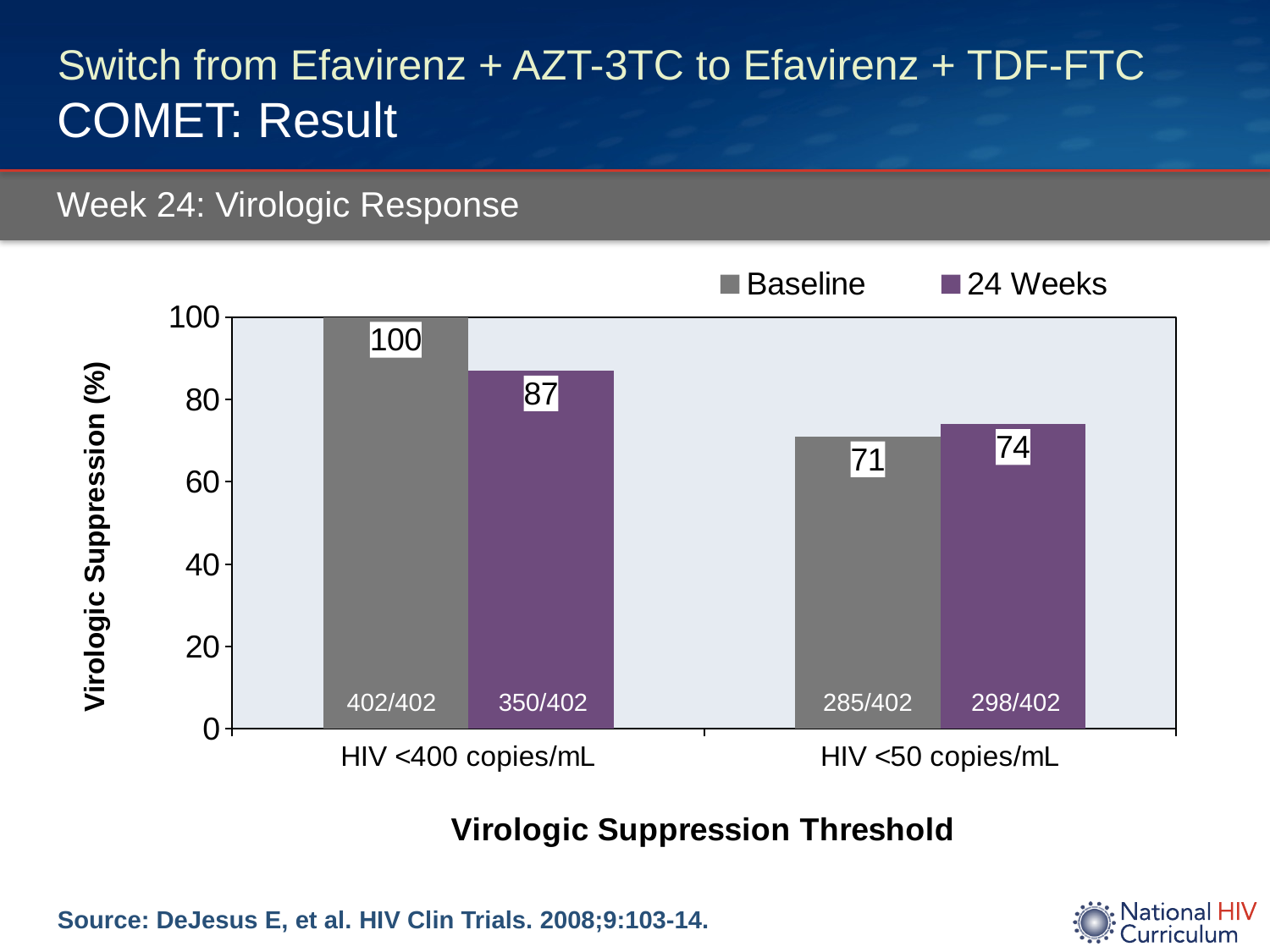
What type of chart is shown on the slide? Bar chart For HIV <50 copies/mL, which is larger: the Baseline value or the 24 Weeks value? 24 Weeks Which bar has the highest value on the chart? Baseline, HIV <400 copies/mL What is the difference between the Baseline and 24 Weeks values for HIV <400 copies/mL? 13 What is the 24 Weeks value for HIV <400 copies/mL? 87 Which bar has the lowest value on the chart? Baseline, HIV <50 copies/mL How many series does the legend list? 2 What is the Baseline value for HIV <400 copies/mL? 100 How many categories are shown on the x axis? 2 What is the 24 Weeks value for HIV <50 copies/mL? 74 What is the Baseline value for HIV <50 copies/mL? 71 What fraction of patients is shown inside the 24 Weeks bar for HIV <50 copies/mL? 298/402